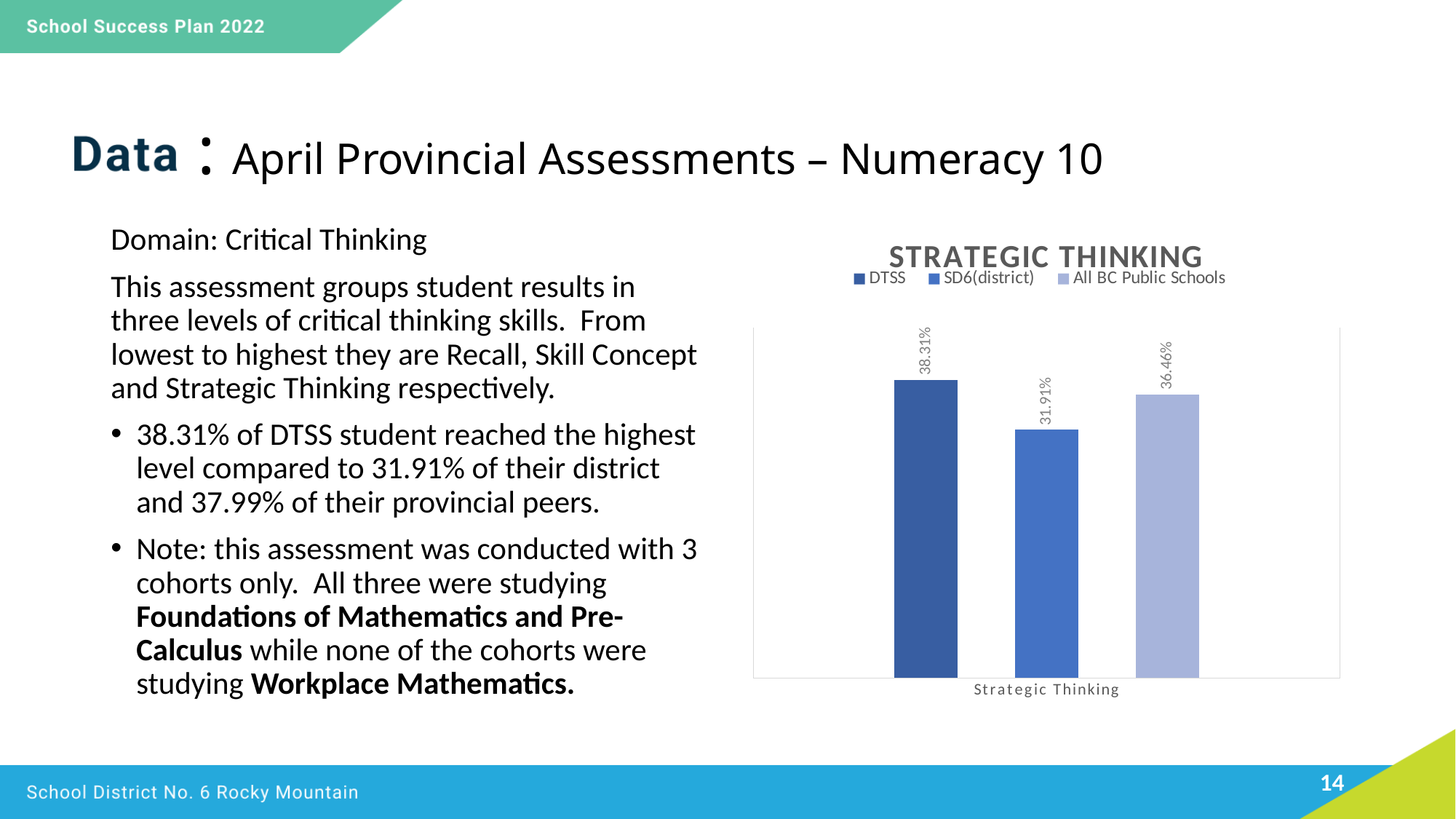
How many categories are shown on the x axis of the Strategic Thinking chart? 1 What is the value for DTSS in the Strategic Thinking chart? 38.31% Which is larger in the Strategic Thinking chart, the value for SD6(district) or the value for All BC Public Schools? All BC Public Schools What kind of chart is the Strategic Thinking chart? Bar chart What is the difference between the DTSS value and the SD6(district) value in the Strategic Thinking chart? 6.40% How many series does the legend of the Strategic Thinking chart list? 3 What is the title of the chart on the slide? STRATEGIC THINKING Which series has the lowest value in the Strategic Thinking chart? SD6(district) What is the difference between the DTSS value and the All BC Public Schools value in the Strategic Thinking chart? 1.85% What is the value for All BC Public Schools in the Strategic Thinking chart? 36.46% Which series has the highest value in the Strategic Thinking chart? DTSS What is the value for SD6(district) in the Strategic Thinking chart? 31.91%